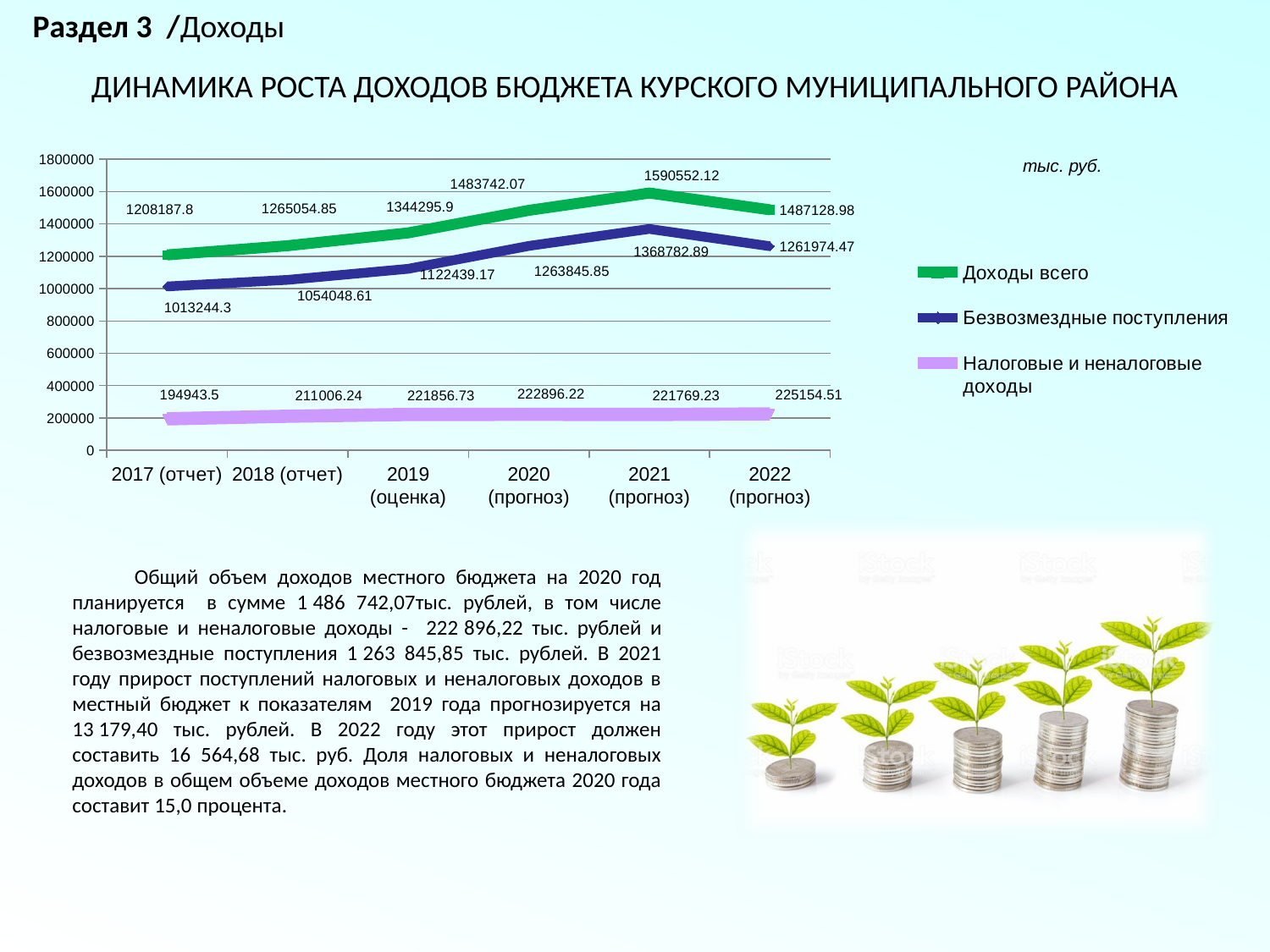
Which is larger in 2022 (прогноз): Безвозмездные поступления or Налоговые и неналоговые доходы? Безвозмездные поступления In which year does Доходы всего reach its highest value? 2021 (прогноз) What is the value of Налоговые и неналоговые доходы for 2022 (прогноз)? 225154.51 In which year is Налоговые и неналоговые доходы lowest? 2017 (отчет) What unit is indicated next to the chart? тыс. руб. What is the difference between Доходы всего and Безвозмездные поступления in 2020 (прогноз)? 219896.22 What type of chart is shown on the slide? line chart Is the value of Безвозмездные поступления for 2021 (прогноз) greater or less than 1200000? greater How many years are shown on the x axis of the chart? 6 What is the value of Безвозмездные поступления for 2017 (отчет)? 1013244.3 What is the value of Доходы всего for 2021 (прогноз)? 1590552.12 How many series does the chart legend list? 3